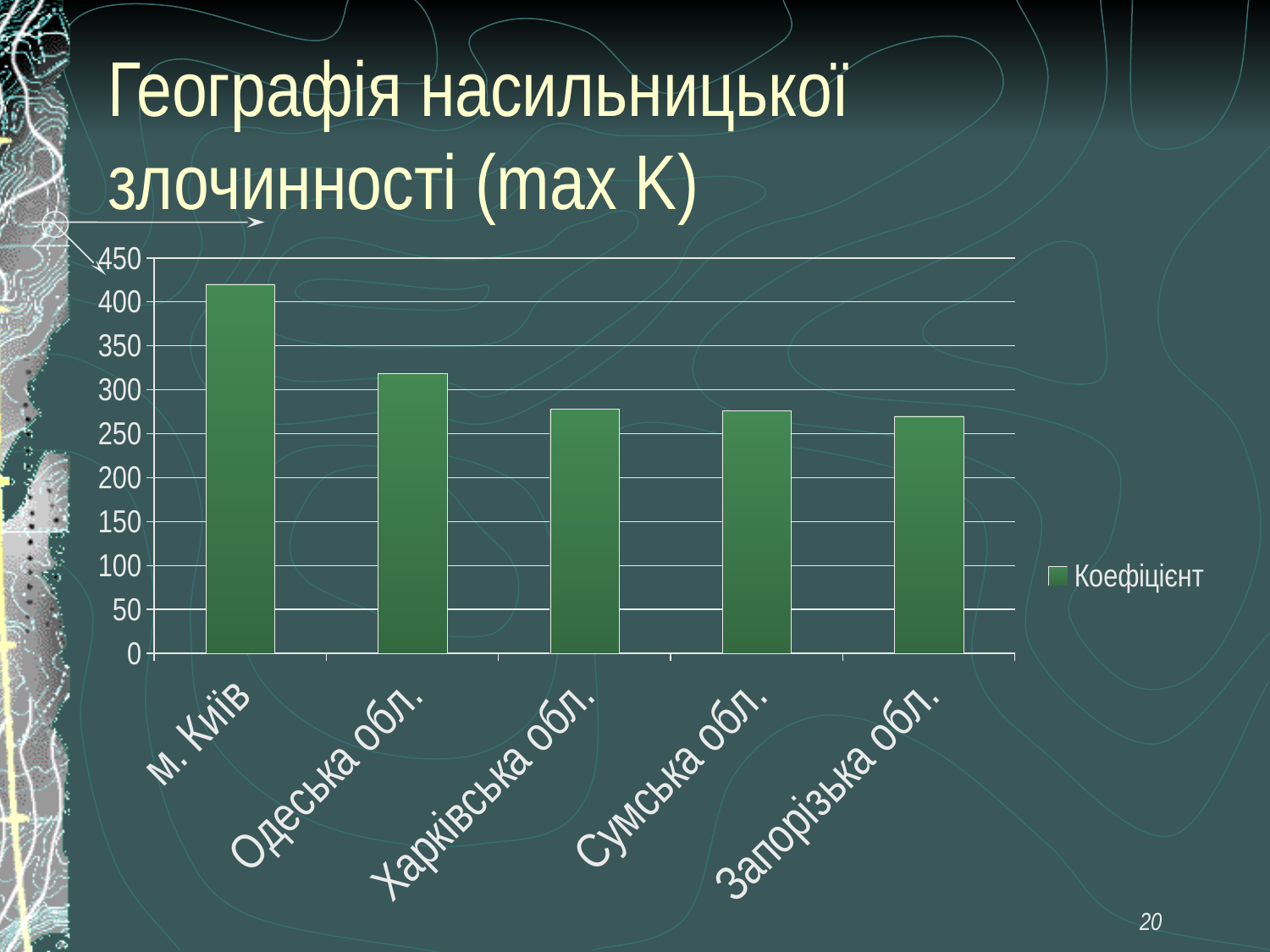
Do the values rise or fall from left to right along the x axis? fall How many series does the chart legend list? 1 Is the value for м. Київ greater or less than 400? greater Which is larger, the value for Одеська обл. or the value for Запорізька обл.? Одеська обл. How many categories are shown on the x axis of the chart? 5 Which category has the highest value in the chart? м. Київ What series name is shown in the chart legend? Коефіцієнт What kind of chart is shown on the slide? bar chart Is the value for Запорізька обл. greater or less than 250? greater Is the value for Одеська обл. greater or less than 300? greater Which is larger, the value for м. Київ or the value for Одеська обл.? м. Київ